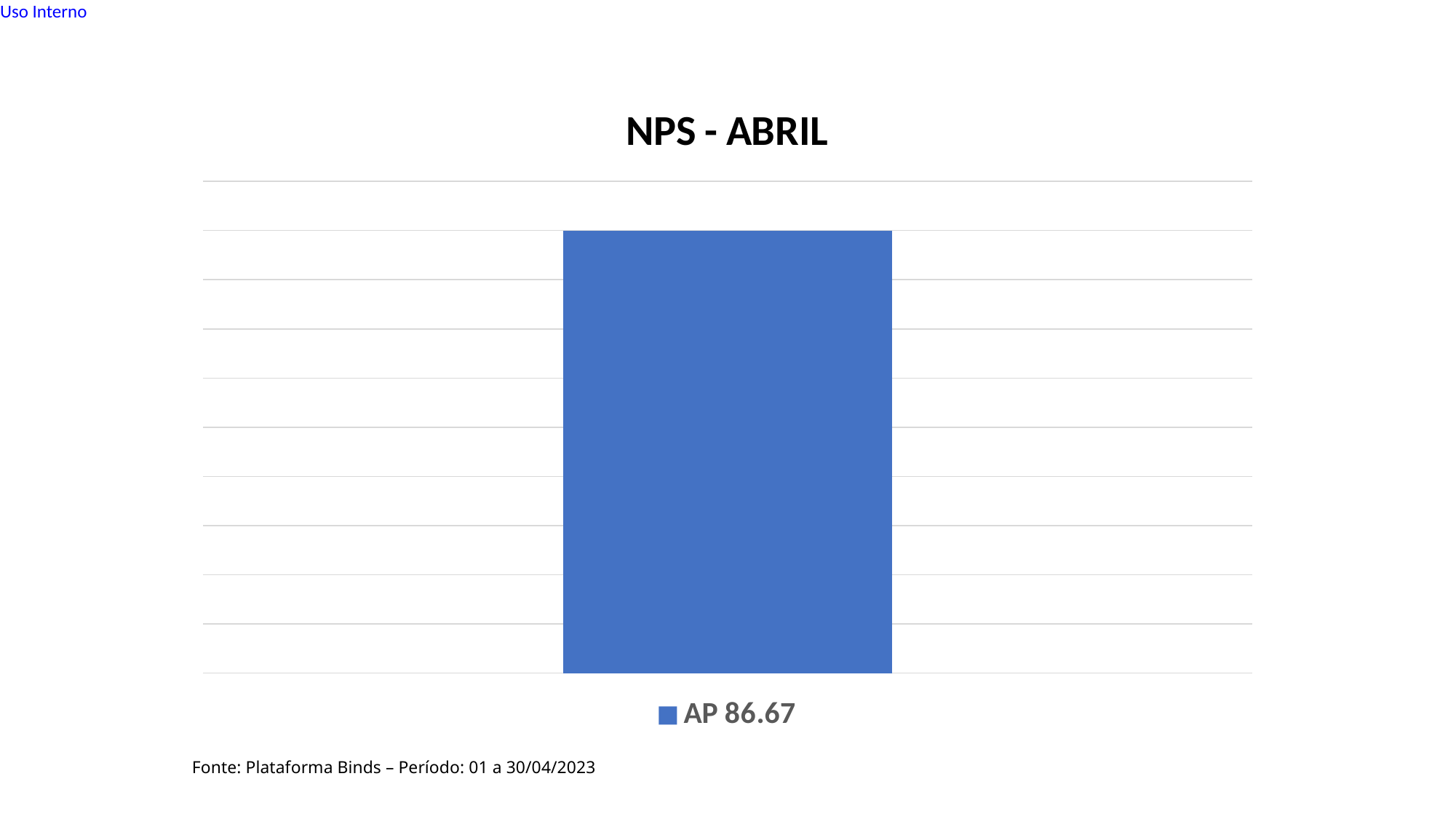
What is the legend entry shown below the chart? AP 86.67 What NPS value is shown for AP in the chart? 86.67 How many series does the legend list? 1 What kind of chart is shown on the slide? bar chart How many bars are plotted in the chart? 1 What is the title of the chart? NPS - ABRIL